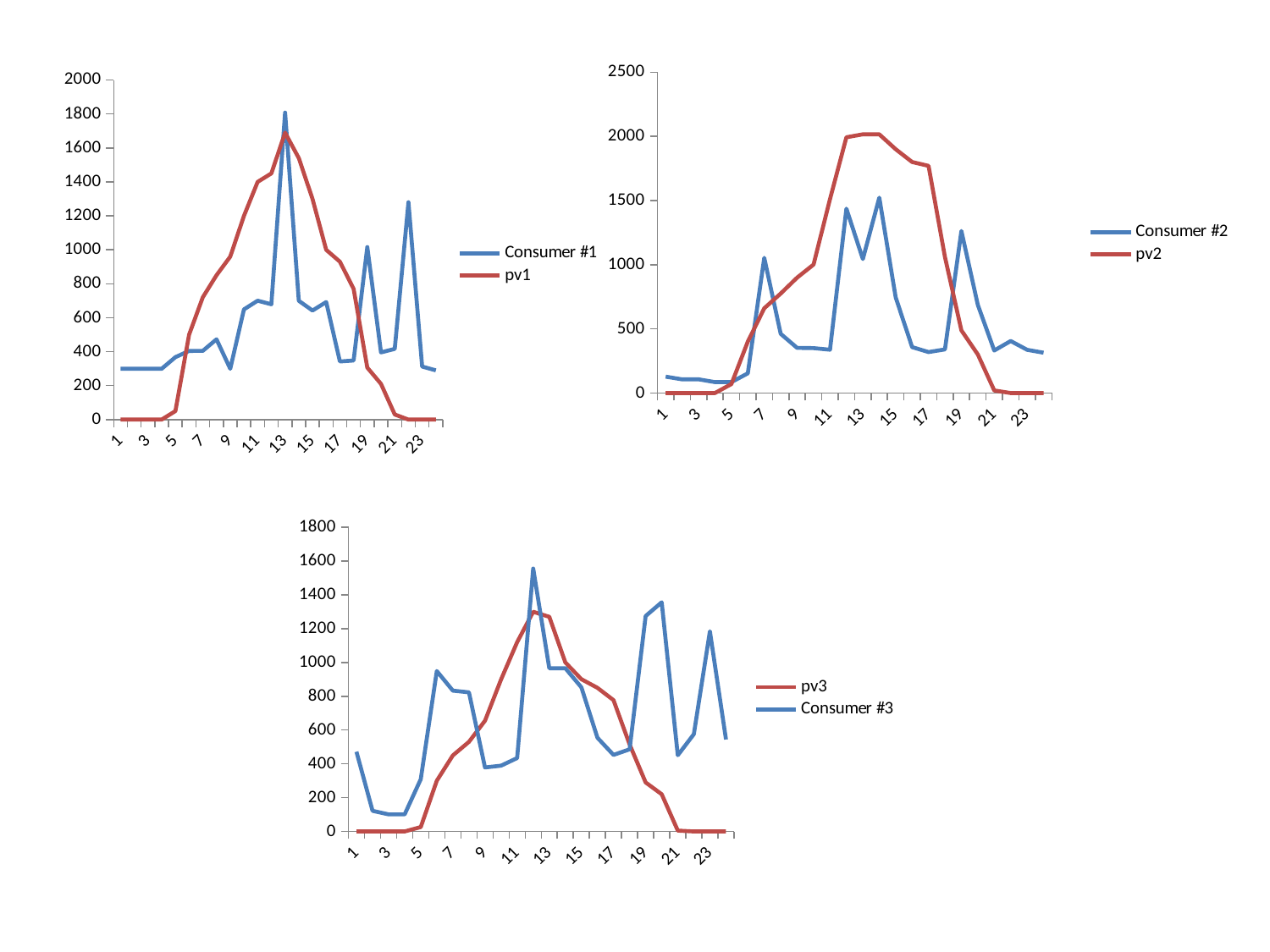
In the top-right chart, at hour 13, which series has the larger value, Consumer #2 or pv2? pv2 In the top-left chart, is the value of pv1 at hour 1 greater or less than 200? less How many series does the legend of the top-left chart list? 2 What kind of chart is the top-left chart? line chart In the top-left chart, at hour 9, which series has the larger value, Consumer #1 or pv1? pv1 In the top-left chart, is the peak value of Consumer #1 at hour 13 greater or less than 1600? greater In the top-right chart, is the value of Consumer #2 at hour 1 greater or less than 500? less In the bottom chart, which series is drawn in red? pv3 What are the two series named in the legend of the top-right chart? Consumer #2 and pv2 In the bottom chart, at hour 7, which series has the larger value, pv3 or Consumer #3? Consumer #3